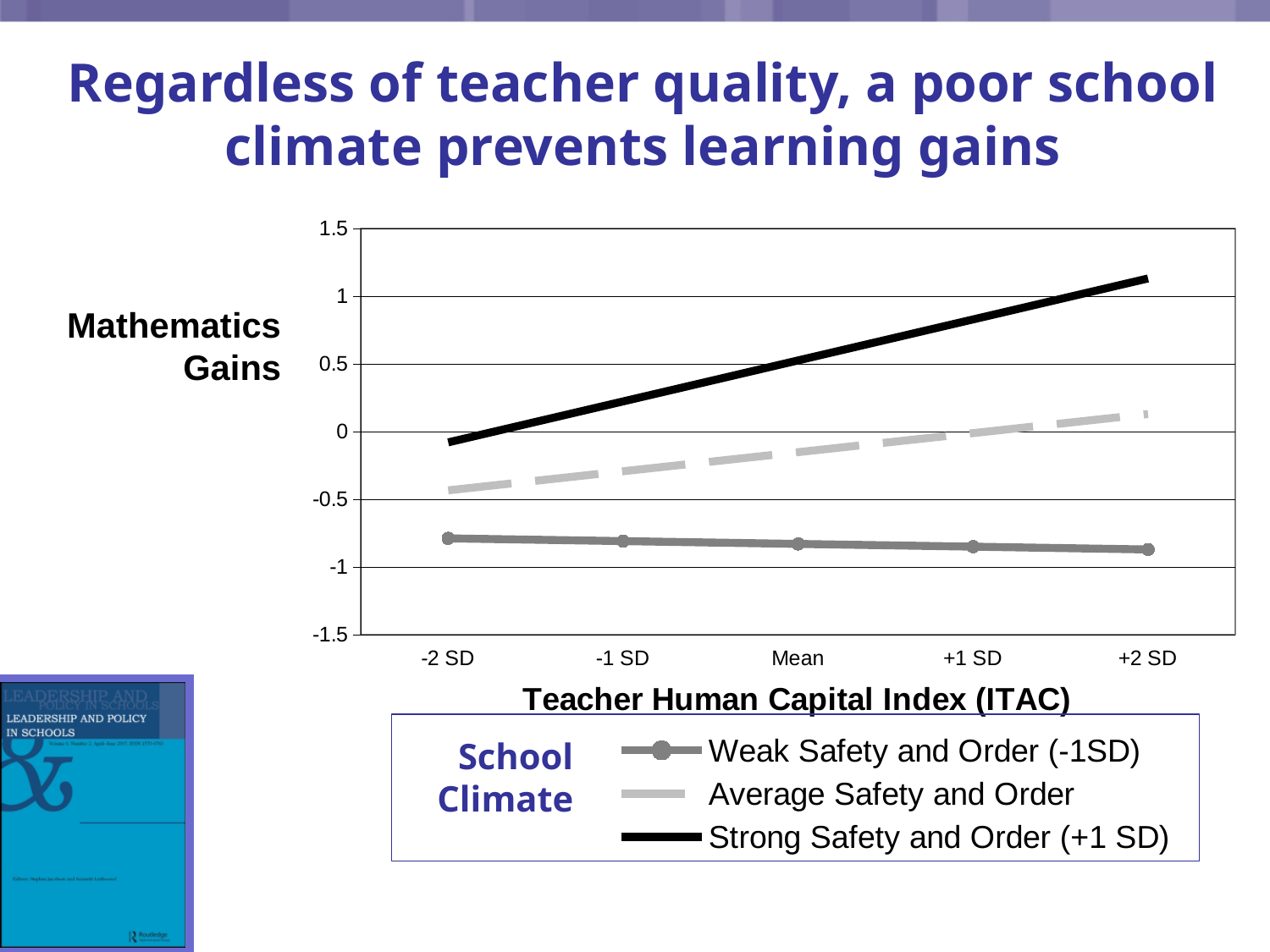
Is the value for Average Safety and Order at Mean greater or less than 0? less Do the values for Strong Safety and Order (+1 SD) rise or fall from -2 SD to +2 SD? rise Is the value for Weak Safety and Order (-1SD) at -2 SD greater or less than -0.5? less Which series has the highest value at +2 SD? Strong Safety and Order (+1 SD) Do the values for Weak Safety and Order (-1SD) rise or fall from -2 SD to +2 SD? fall At -2 SD, which is larger: the value for Average Safety and Order or the value for Weak Safety and Order (-1SD)? Average Safety and Order Is the value for Strong Safety and Order (+1 SD) at +1 SD greater or less than 0.5? greater What kind of chart is shown on the slide? line chart How many series does the legend list? 3 What is the title of the x axis? Teacher Human Capital Index (ITAC) Which series has the lowest value at -2 SD? Weak Safety and Order (-1SD) How many categories are shown on the x axis? 5